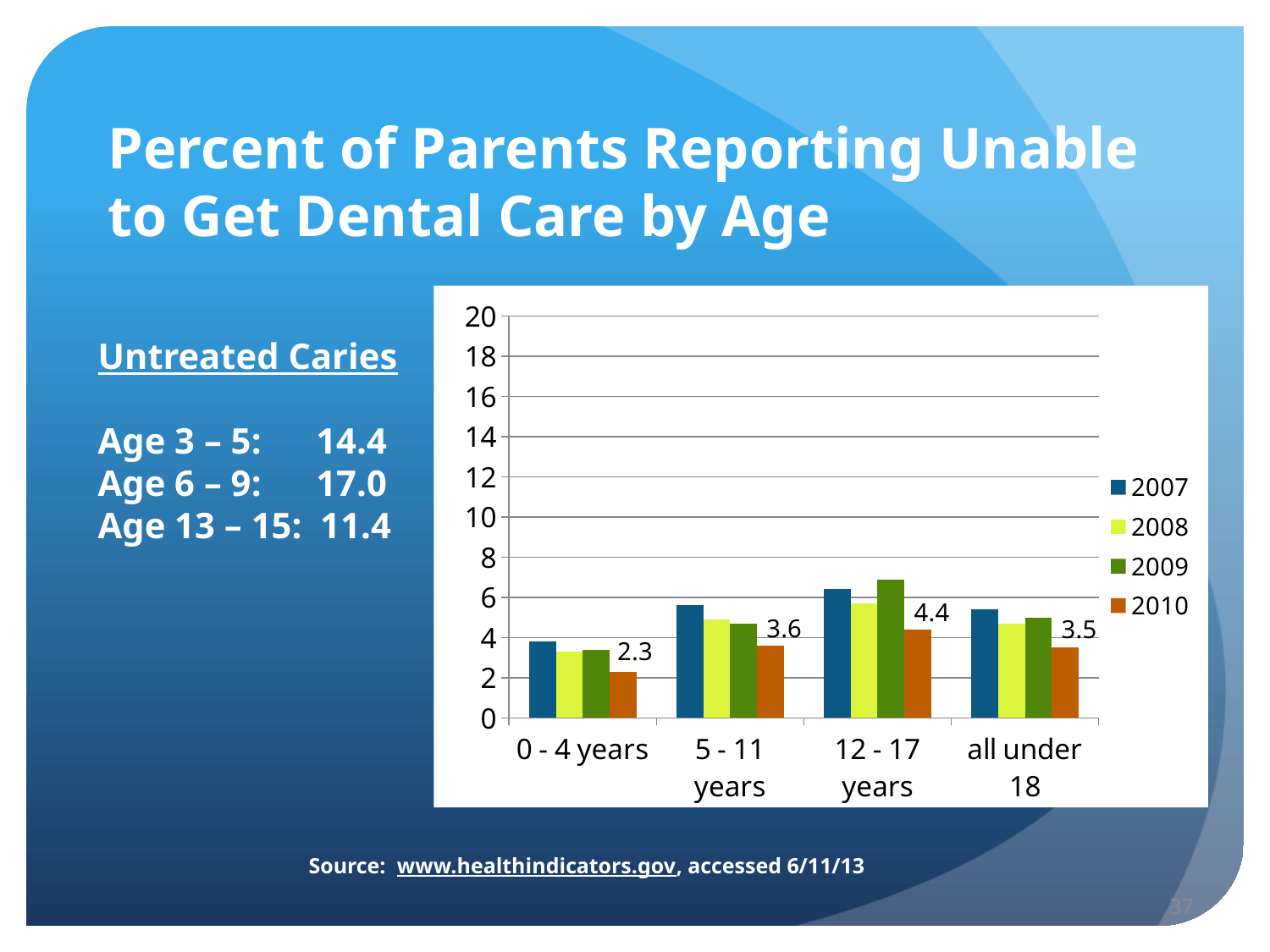
What is the 2010 value for 12 - 17 years? 4.4 Which is larger in 2010: the value for 5 - 11 years or for all under 18? 5 - 11 years What is the 2010 value for 5 - 11 years? 3.6 Which age group has the highest 2010 value? 12 - 17 years What is the difference between the 2010 values for 12 - 17 years and 0 - 4 years? 2.1 How many age groups are shown on the x axis? 4 How many series does the legend list? 4 What is the 2010 value for all under 18? 3.5 Is the 2008 value for 0 - 4 years greater or less than 4? less Is the 2009 value for 12 - 17 years greater or less than 6? greater What is the 2010 value for 0 - 4 years? 2.3 Which age group has the lowest 2010 value? 0 - 4 years